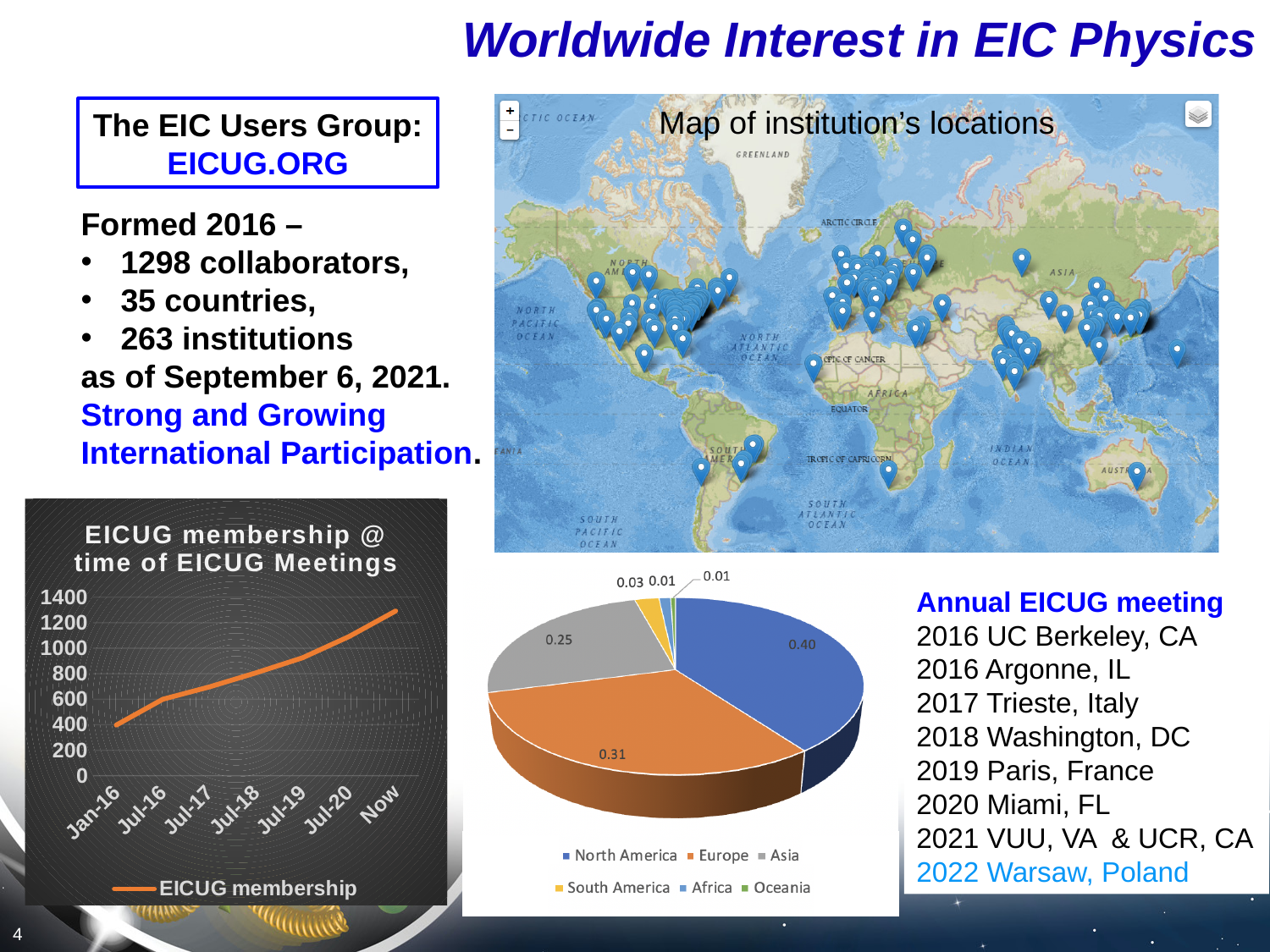
What series name does the legend of the 'EICUG membership @ time of EICUG Meetings' chart show? EICUG membership In the pie chart at the bottom centre, what is the value for North America? 0.40 In the 'EICUG membership @ time of EICUG Meetings' chart, is the value for Jul-20 greater or less than 800? greater How many regions does the legend of the pie chart at the bottom centre list? 6 What kind of chart is the 'EICUG membership @ time of EICUG Meetings' chart? line chart In the 'EICUG membership @ time of EICUG Meetings' chart, do the values rise or fall from Jan-16 to Now? rise How many points are plotted along the x axis of the 'EICUG membership @ time of EICUG Meetings' chart? 7 In the 'EICUG membership @ time of EICUG Meetings' chart, is the value for Jan-16 greater or less than 600? less In the pie chart at the bottom centre, what is the difference between the values for North America and Europe? 0.09 In the 'EICUG membership @ time of EICUG Meetings' chart, is the value for Now greater or less than 1000? greater What kind of chart is the chart at the bottom centre of the slide showing regions? pie chart In the pie chart at the bottom centre, which region has the largest slice? North America